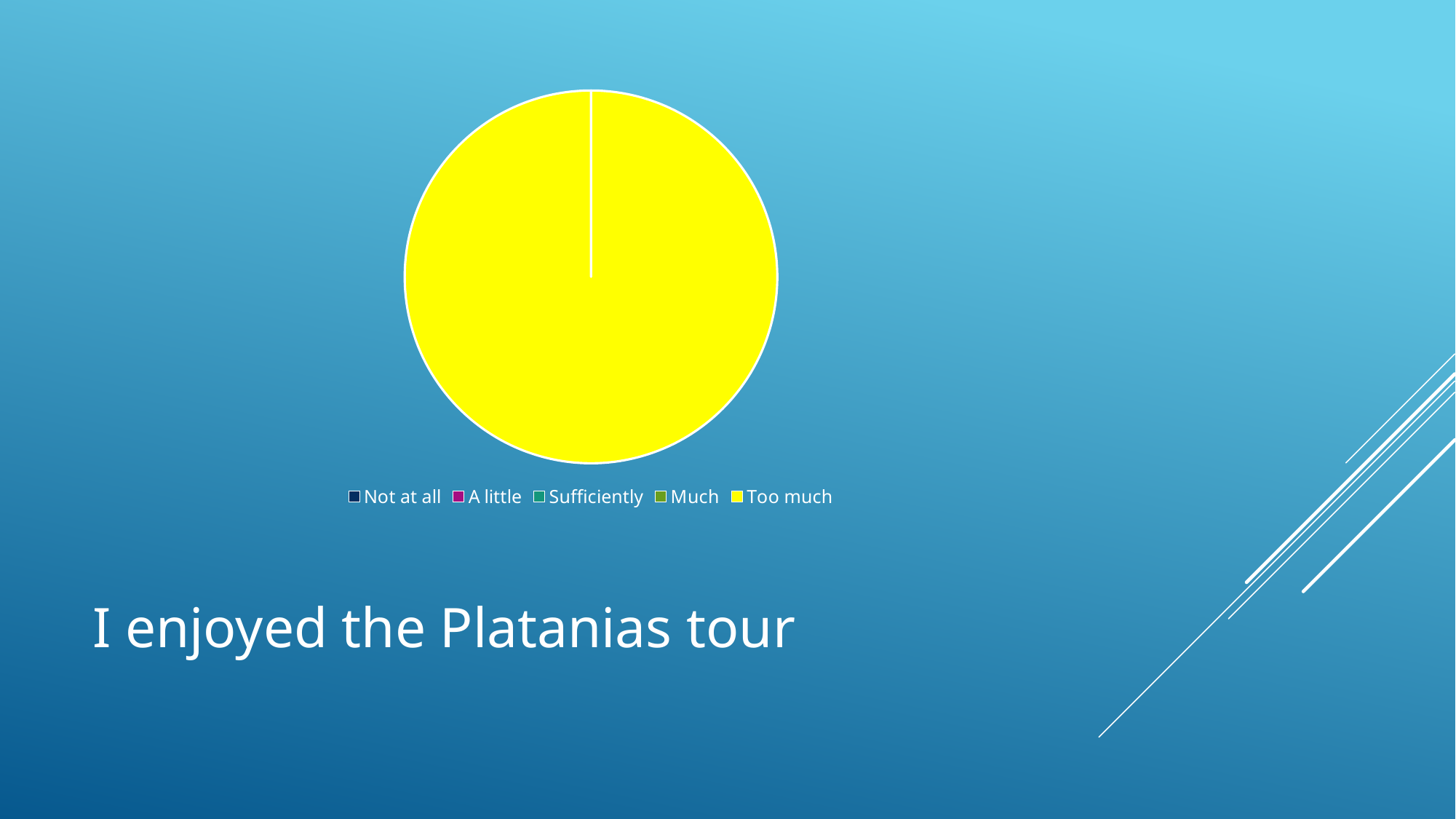
What is the first entry listed in the pie chart's legend? Not at all Which category takes up the largest share of the pie chart? Too much How many slices are visible in the pie chart? 1 What colour represents 'Too much' in the pie chart? yellow What kind of chart is shown on the slide? pie chart How many categories does the legend of the pie chart list? 5 Which is larger in the pie chart, the share for 'Too much' or the share for 'Not at all'? Too much Which is larger in the pie chart, the share for 'Much' or the share for 'Too much'? Too much